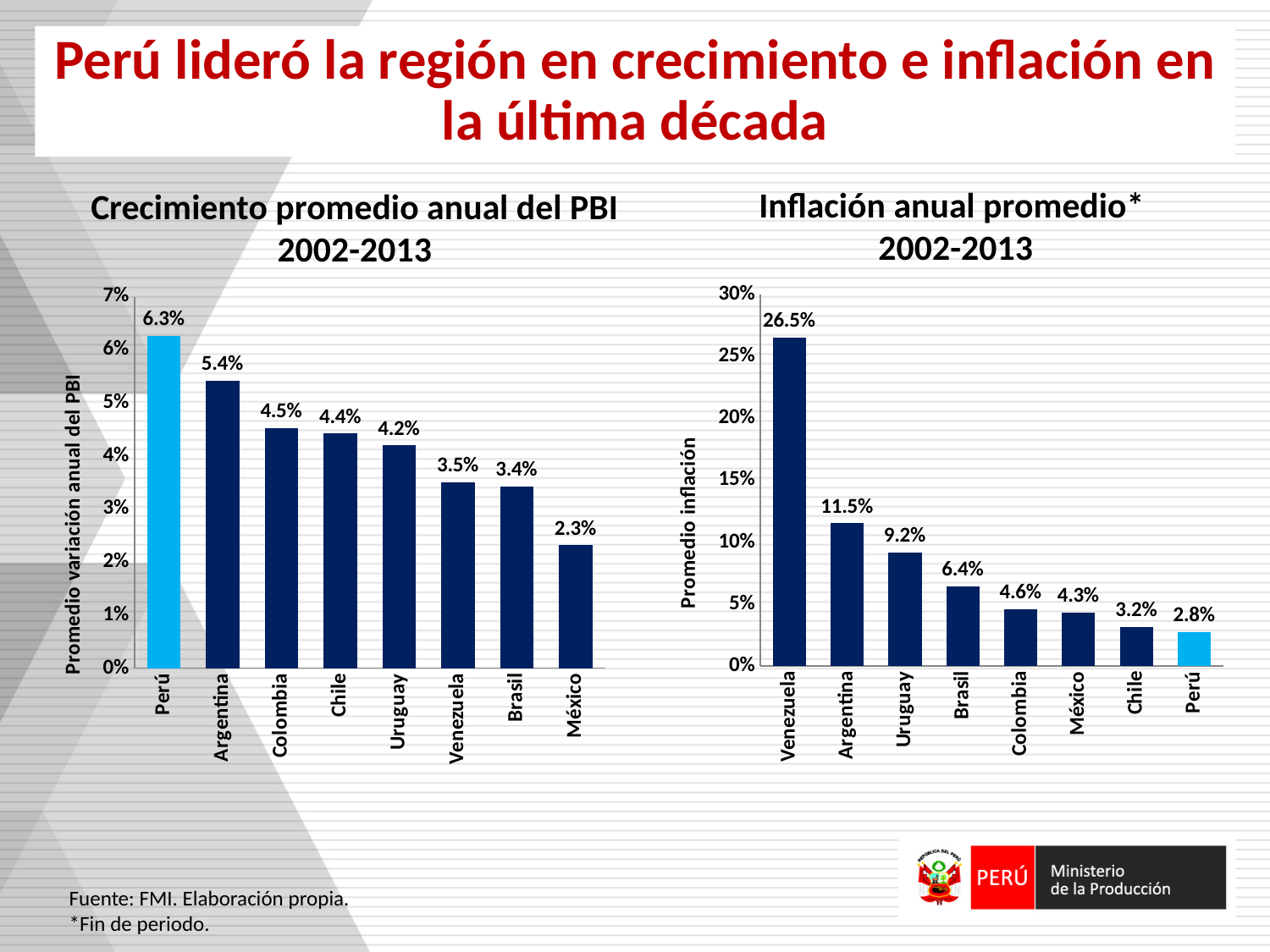
In the 'Crecimiento promedio anual del PBI 2002-2013' chart, what is the difference between Perú and Argentina? 0.9% In the 'Crecimiento promedio anual del PBI 2002-2013' chart, which bar is shown in a lighter blue colour than the others? Perú In the 'Crecimiento promedio anual del PBI 2002-2013' chart, which country has the lowest value? México In the 'Crecimiento promedio anual del PBI 2002-2013' chart, what is the value for Perú? 6.3% In the 'Crecimiento promedio anual del PBI 2002-2013' chart, how many countries are shown? 8 In the 'Inflación anual promedio* 2002-2013' chart, what is the value for Venezuela? 26.5% In the 'Inflación anual promedio* 2002-2013' chart, what is the value for Brasil? 6.4% What kind of chart is the 'Inflación anual promedio* 2002-2013' chart? bar chart In the 'Inflación anual promedio* 2002-2013' chart, do the values rise or fall from left to right? fall In the 'Inflación anual promedio* 2002-2013' chart, which country has the lowest value? Perú In the 'Inflación anual promedio* 2002-2013' chart, what is the difference between Argentina and Uruguay? 2.3% In the 'Crecimiento promedio anual del PBI 2002-2013' chart, which is larger, Chile or Uruguay? Chile